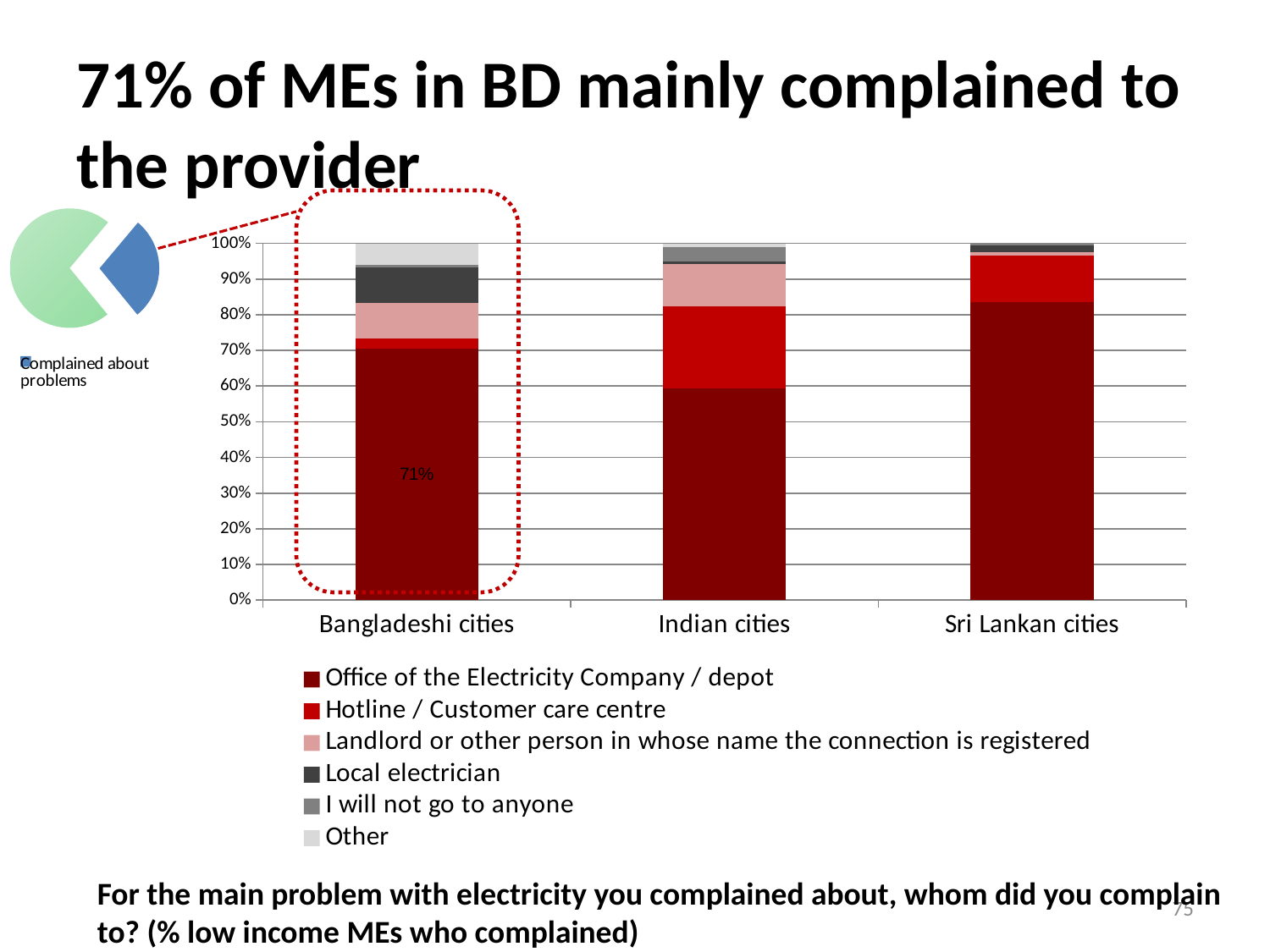
How many city groups (categories) are shown on the x axis of the stacked bar chart? 3 Which city group has the largest share complaining to the Office of the Electricity Company / depot? Sri Lankan cities Which city group has the smallest share complaining to the Office of the Electricity Company / depot? Indian cities Which city group's bar is highlighted with a dotted red outline? Bangladeshi cities Is the Local electrician segment larger for Bangladeshi cities or for Sri Lankan cities? Bangladeshi cities What kind of chart is the main chart on the slide? Stacked bar chart What is the highest value shown on the y axis of the stacked bar chart? 100% What percentage of low income MEs in Bangladeshi cities complained to the Office of the Electricity Company / depot? 71% Is the share complaining to the Office of the Electricity Company / depot in Sri Lankan cities greater or less than 70%? greater Is the Hotline / Customer care centre segment larger for Indian cities or for Bangladeshi cities? Indian cities Is the share complaining to the Office of the Electricity Company / depot in Indian cities greater or less than 50%? greater How many series does the legend of the stacked bar chart list? 6